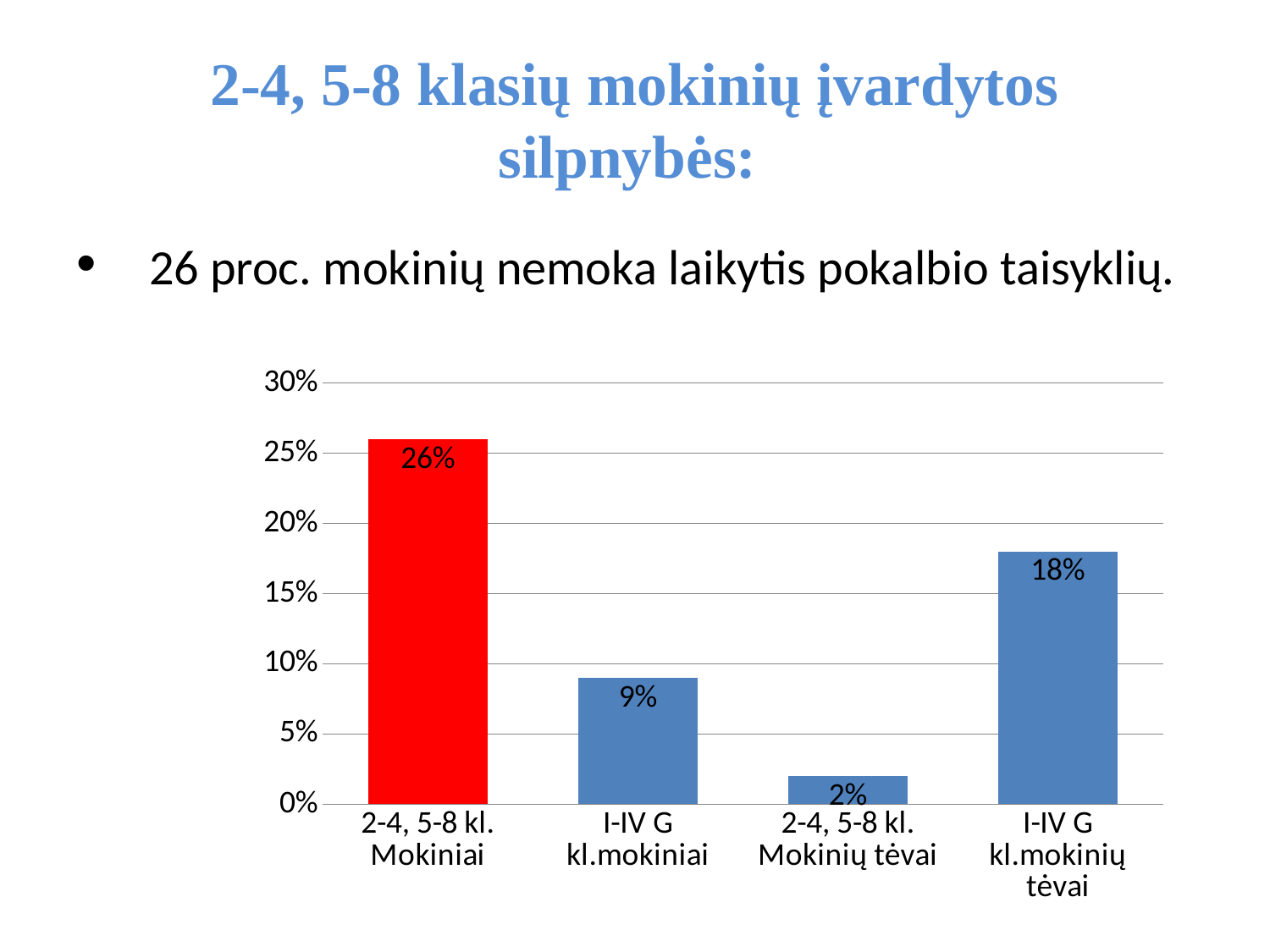
What is the difference between the values for "2-4, 5-8 kl. Mokiniai" and "I-IV G kl.mokinių tėvai"? 8% How many categories are shown on the chart? 4 What is the value for "2-4, 5-8 kl. Mokiniai"? 26% Which category has the highest value? 2-4, 5-8 kl. Mokiniai What is the value for "I-IV G kl.mokiniai"? 9% Is the value for "I-IV G kl.mokinių tėvai" greater or less than 15%? greater Which category has the lowest value? 2-4, 5-8 kl. Mokinių tėvai What is the difference between the values for "I-IV G kl.mokiniai" and "2-4, 5-8 kl. Mokinių tėvai"? 7% Which is larger, the value for "I-IV G kl.mokiniai" or the value for "I-IV G kl.mokinių tėvai"? I-IV G kl.mokinių tėvai What is the value for "I-IV G kl.mokinių tėvai"? 18% What is the value for "2-4, 5-8 kl. Mokinių tėvai"? 2% What kind of chart is shown on the slide? bar chart